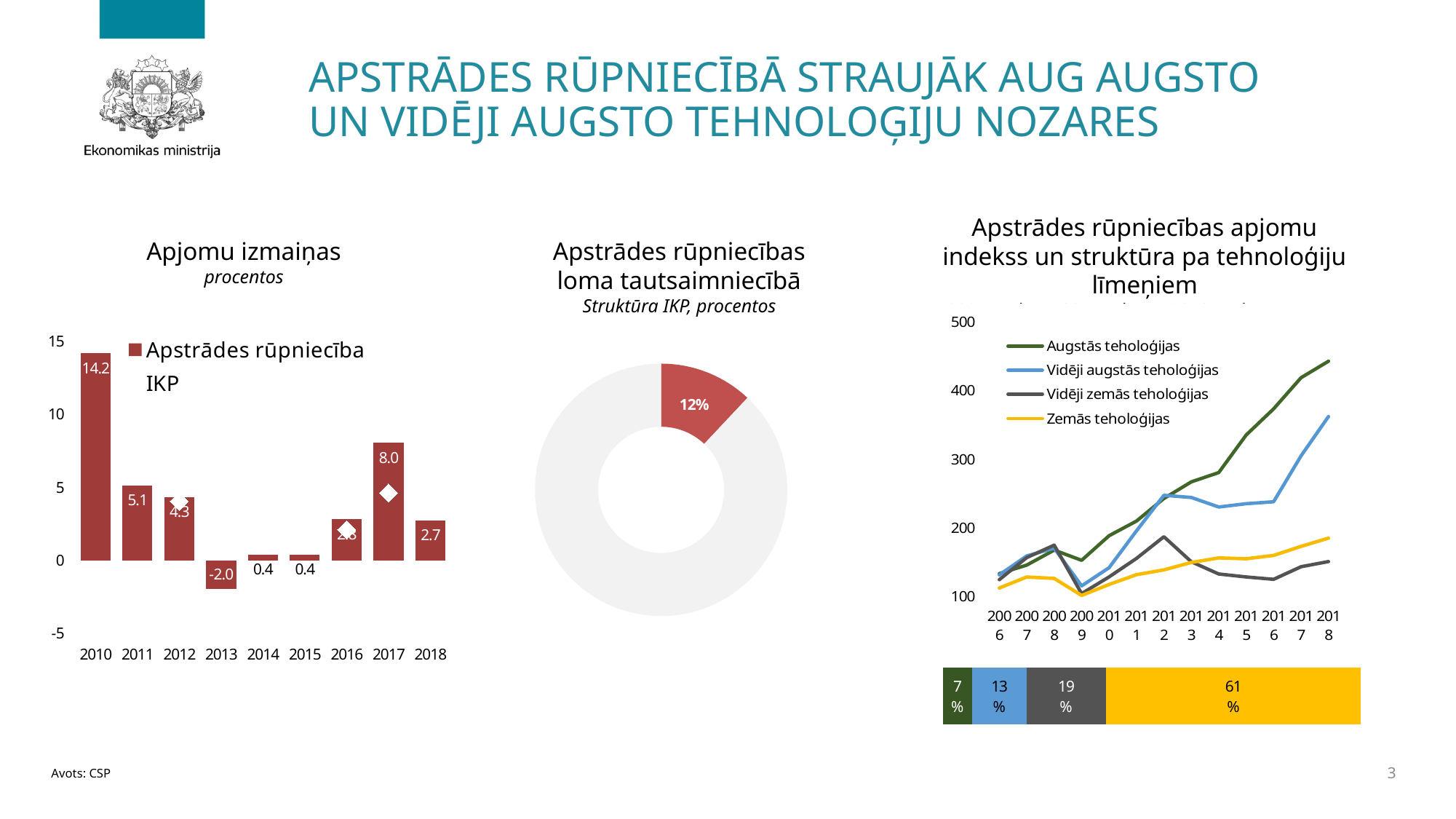
In the 'Apjomu izmaiņas' bar chart, which year has the highest value? 2010 In the 'Apjomu izmaiņas' bar chart, what is the value for 2010? 14.2 In the 'Apstrādes rūpniecības loma tautsaimniecībā' donut chart, what share is shown for the highlighted slice? 12% In the 'Apstrādes rūpniecības apjomu indekss un struktūra pa tehnoloģiju līmeņiem' line chart, how many series does the legend list? 4 In the 'Apjomu izmaiņas' bar chart, what is the difference between the values for 2010 and 2017? 6.2 In the 'Apjomu izmaiņas' bar chart, how many years are shown on the x axis? 9 In the 'Apjomu izmaiņas' bar chart, which year has the lowest value? 2013 In the 'Apstrādes rūpniecības apjomu indekss un struktūra pa tehnoloģiju līmeņiem' line chart, is the value for Augstās tehnoloģijas in 2018 greater or less than 400? greater In the 'Apstrādes rūpniecības apjomu indekss un struktūra pa tehnoloģiju līmeņiem' line chart, which series has the highest value in 2018? Augstās tehnoloģijas In the 'Apjomu izmaiņas' bar chart, what is the value for 2013? -2.0 What kind of chart is the 'Apjomu izmaiņas' chart on the left? bar chart In the stacked bar below the 'Apstrādes rūpniecības apjomu indekss un struktūra pa tehnoloģiju līmeņiem' chart, what share is shown for the yellow (Zemās tehnoloģijas) segment? 61%